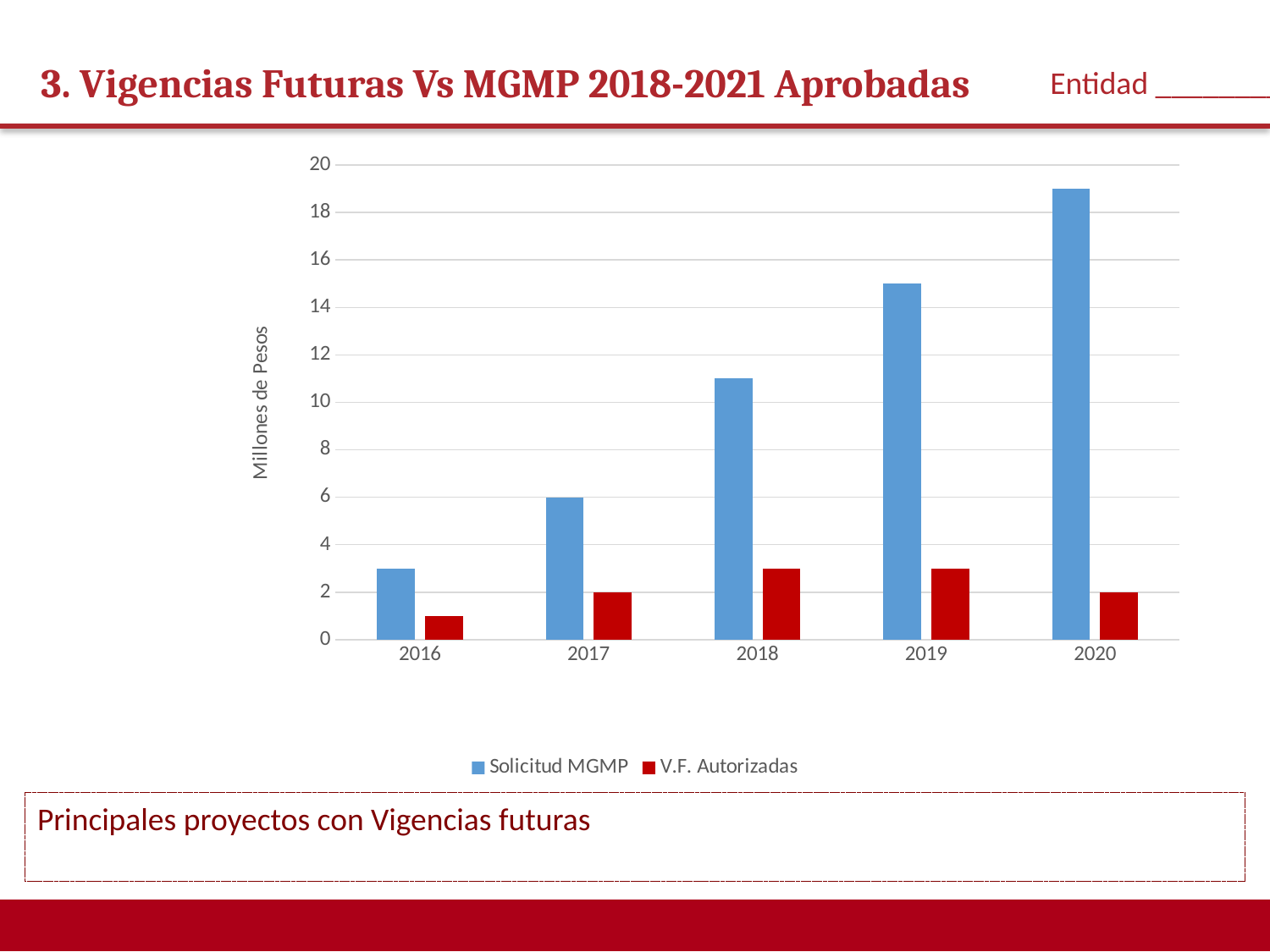
How many years are shown on the x axis? 5 Which year has the highest value for Solicitud MGMP? 2020 Which year has the lowest value for Solicitud MGMP? 2016 What is the value for V.F. Autorizadas in 2020? 2 Is the value for Solicitud MGMP in 2020 greater or less than 18? greater How many series does the legend list? 2 What is the value for V.F. Autorizadas in 2017? 2 What kind of chart is shown on the slide? bar chart Is the value for Solicitud MGMP in 2018 greater or less than 10? greater What is the value for Solicitud MGMP in 2017? 6 Do the Solicitud MGMP values rise or fall from 2016 to 2020? rise Which is larger in 2019, Solicitud MGMP or V.F. Autorizadas? Solicitud MGMP